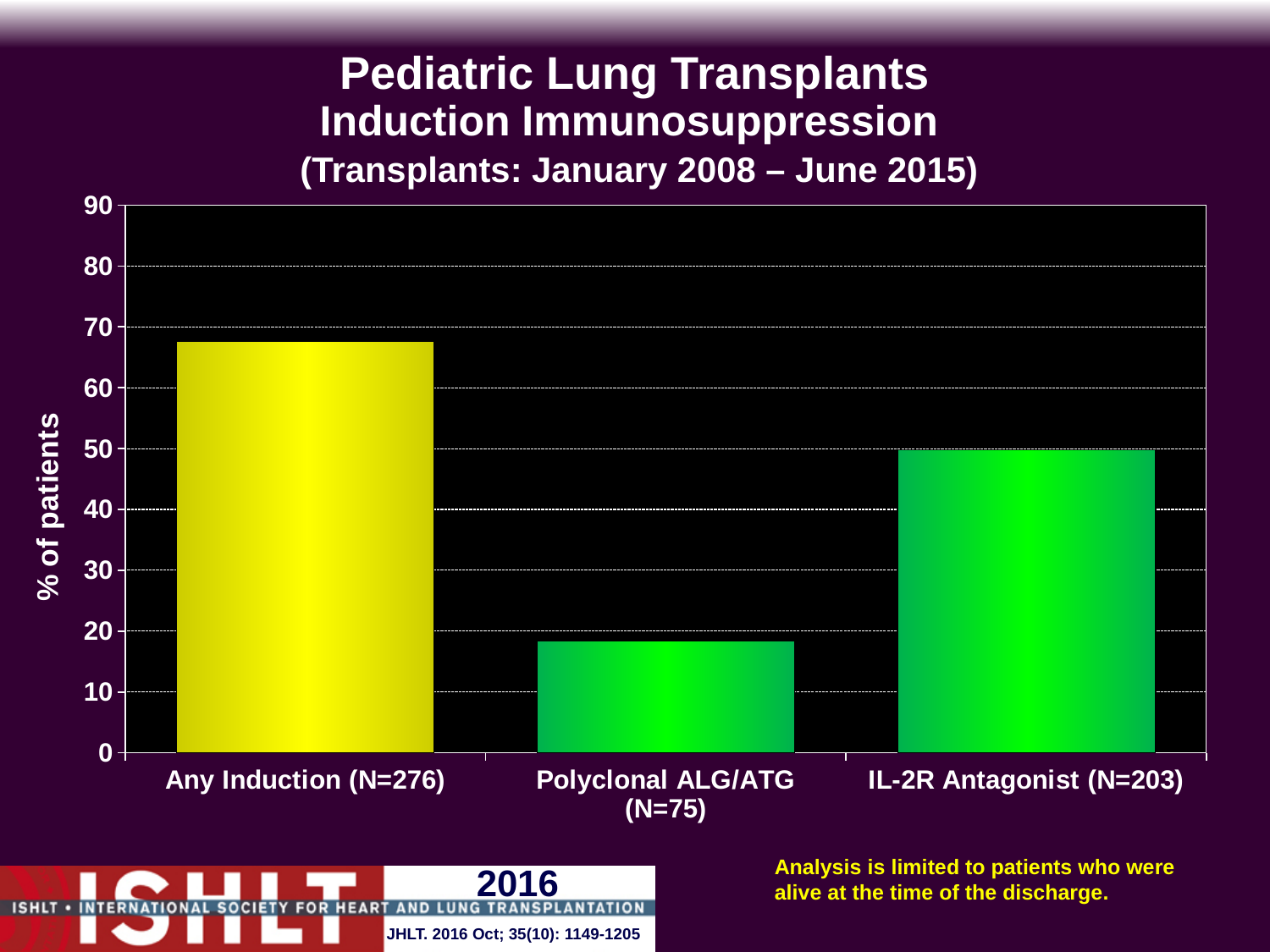
What kind of chart is shown on the slide? bar chart Is the value for IL-2R Antagonist (N=203) greater or less than 40? greater What colour is the bar for Any Induction (N=276)? yellow Is the value for Polyclonal ALG/ATG (N=75) greater or less than 10? greater Is the value for Polyclonal ALG/ATG (N=75) greater or less than 20? less What is the label of the y axis? % of patients How many categories are plotted on the chart? 3 Which category has the highest percentage of patients? Any Induction (N=276) Which category has the lowest percentage of patients? Polyclonal ALG/ATG (N=75) Which is larger, the value for IL-2R Antagonist (N=203) or the value for Polyclonal ALG/ATG (N=75)? IL-2R Antagonist (N=203)